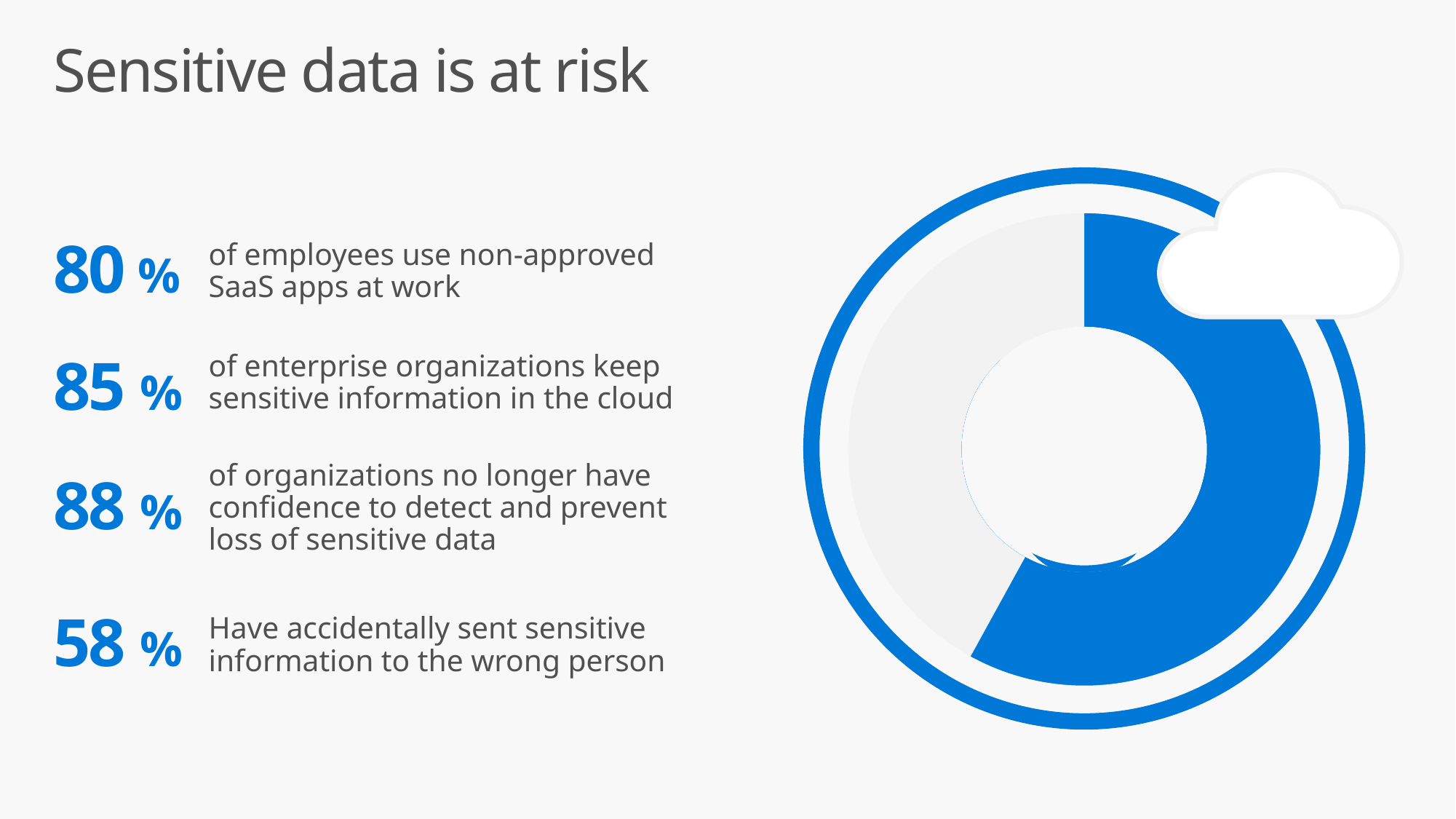
What icon overlaps the top right of the donut chart? A cloud What kind of chart is shown on the right side of the slide? Donut chart Which slice of the donut chart is the largest? The blue slice How many slices does the donut chart on the right have? 2 What two colours are used for the slices of the donut chart? Blue and grey In the donut chart, which slice is larger, the blue one or the grey one? The blue one Which slice of the donut chart is the smallest? The grey slice